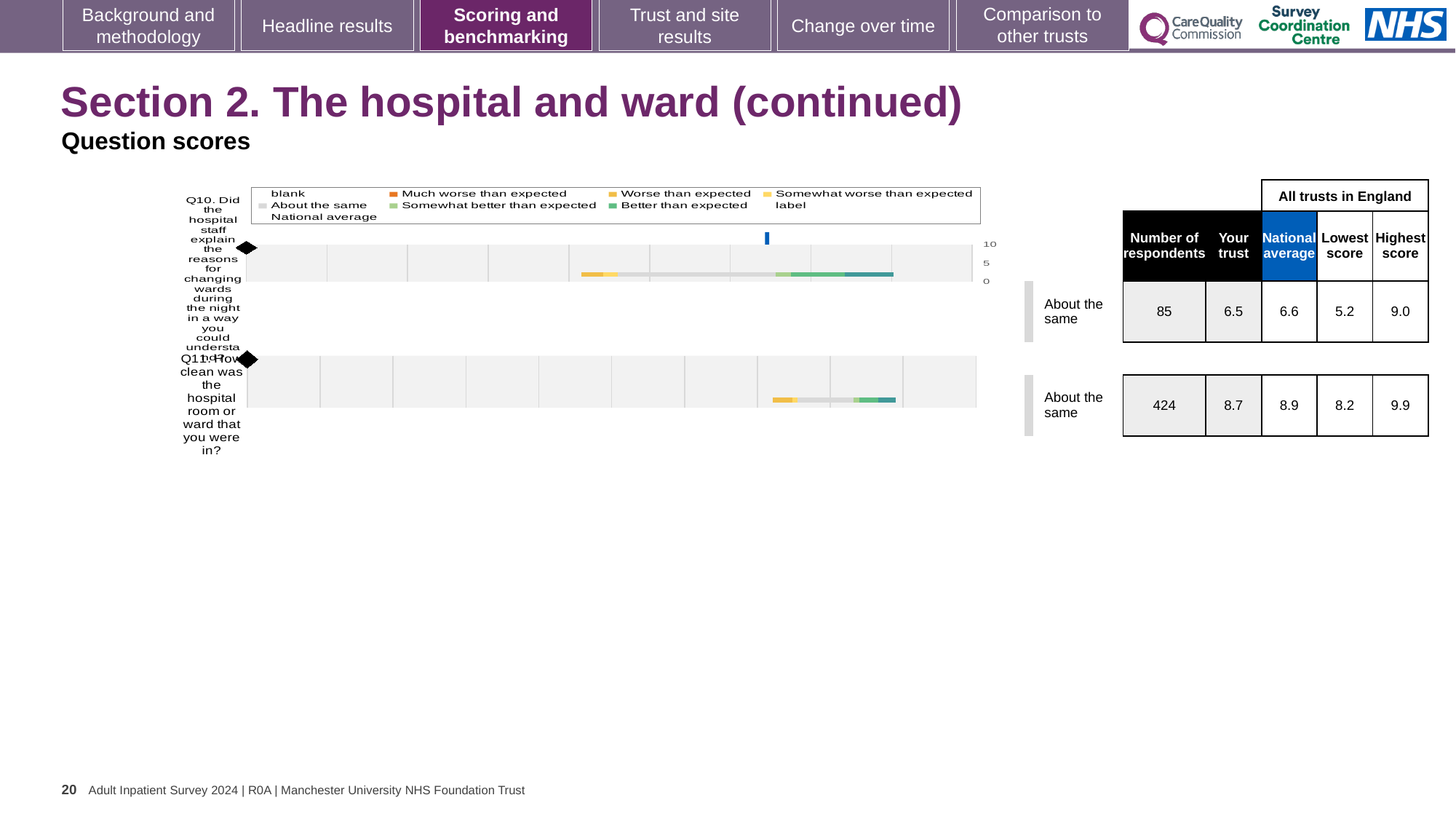
How many questions are plotted in the chart? 2 What is the 'Your trust' score for Q10 (explaining reasons for changing wards during the night)? 6.5 How many respondents answered Q11? 424 Which question has the higher 'Your trust' score, Q10 or Q11? Q11 What is the highest score across all trusts in England for Q11? 9.9 What is the difference between the highest and lowest scores for Q11? 1.7 What is the national average score for Q11 (how clean was the hospital room or ward)? 8.9 For Q10, which is larger: the trust's score or the national average? National average Which question had more respondents, Q10 or Q11? Q11 What kind of chart is used to show the question scores? Bar chart What benchmark category is shown for both Q10 and Q11? About the same What is the lowest score across all trusts in England for Q10? 5.2